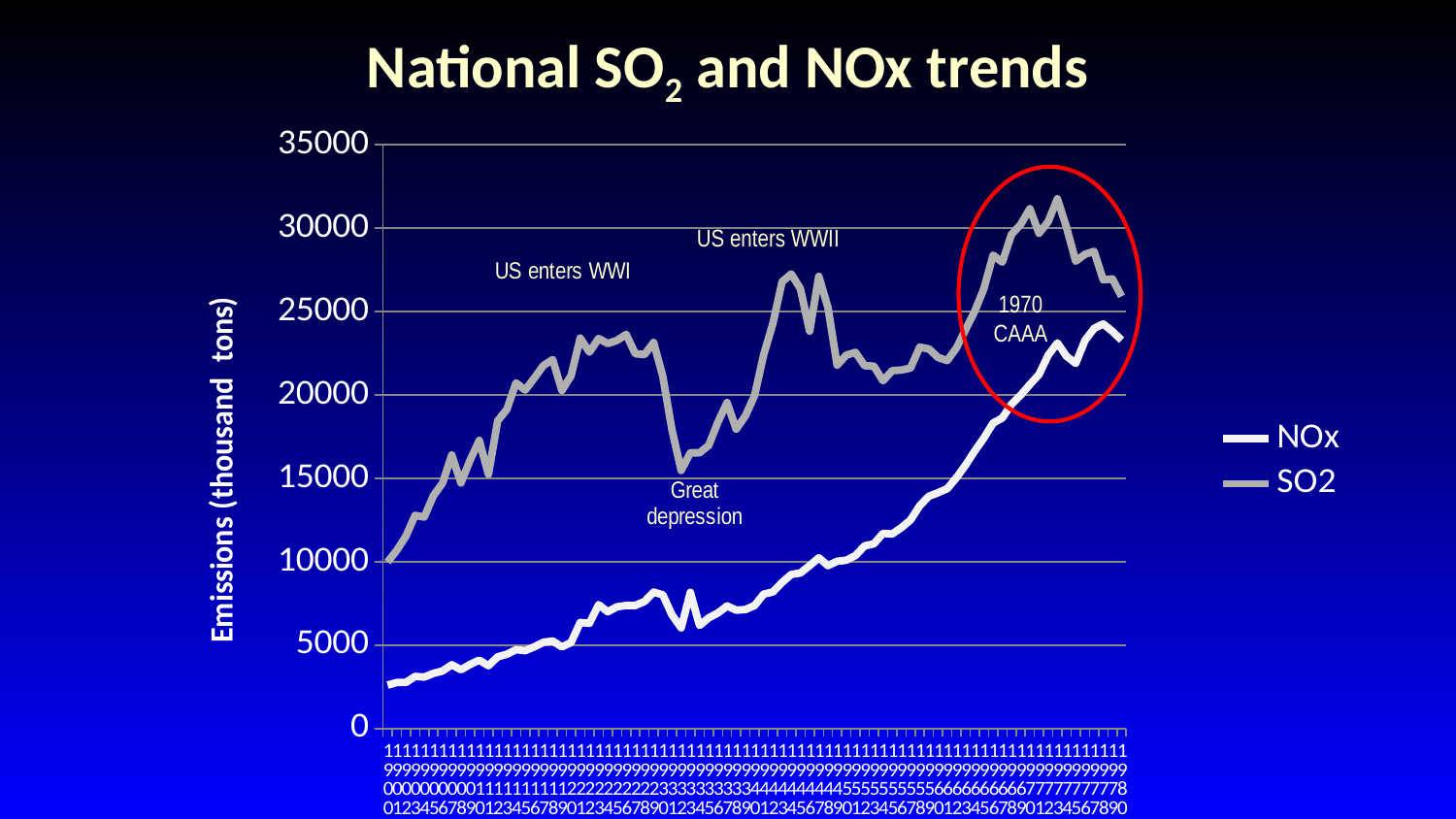
Is the NOx value at the start of the series (1900) greater or less than 5000? less Which series has the higher emissions value in 1970, NOx or SO2? SO2 Which series stays higher than the other across the whole period shown? SO2 Which event is annotated at the sharp dip in the SO2 series in the early 1930s? Great depression Does the NOx series generally rise or fall from 1900 to 1970? rise What kind of chart is shown on the slide? line chart How many series does the legend list? 2 Is the peak value of the SO2 series around 1970 greater or less than 30000? greater What is the label on the y axis of the chart? Emissions (thousand tons) Is the NOx value at the end of the series (1980) greater or less than 20000? greater